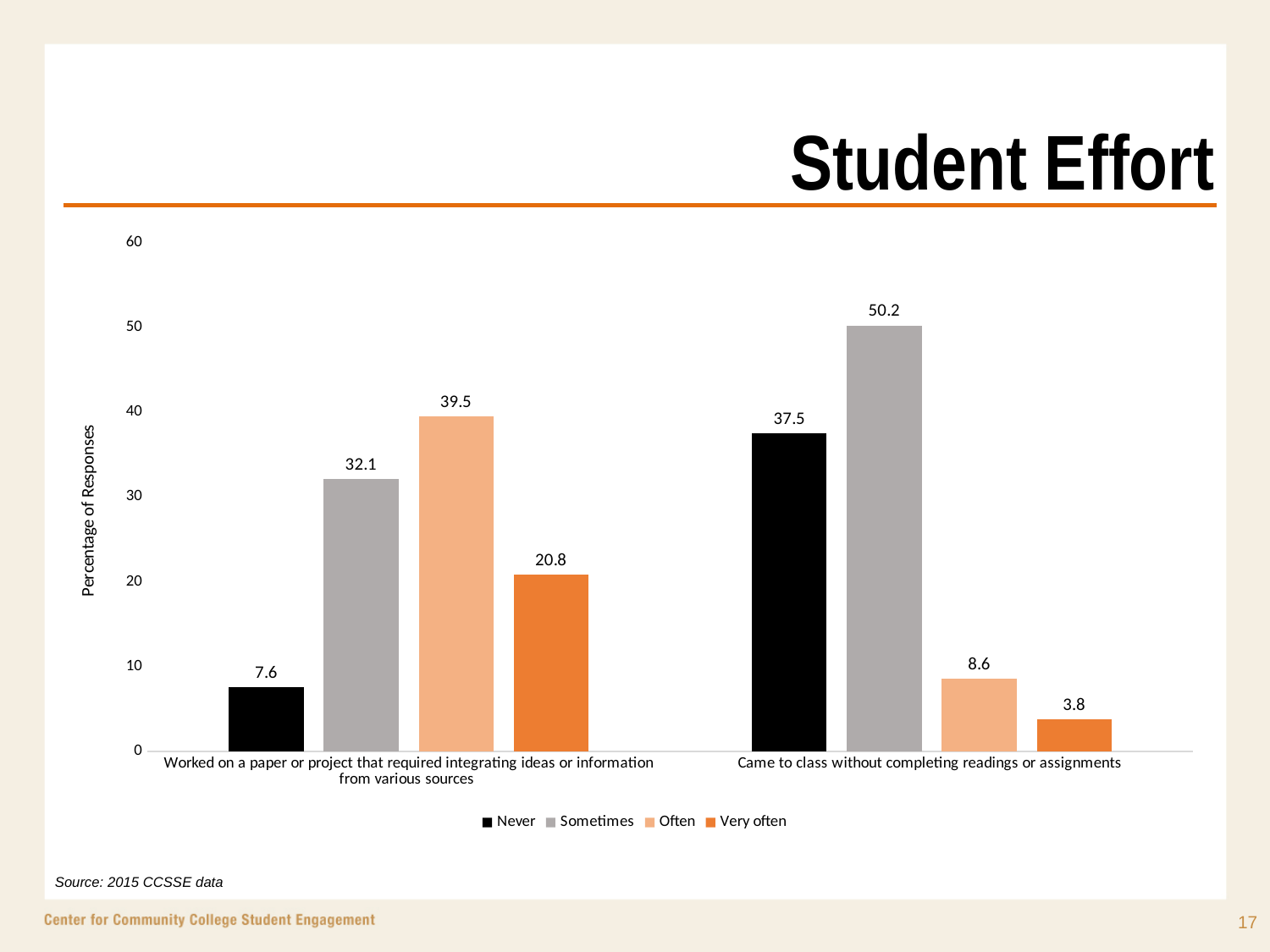
What kind of chart is shown on the slide? Bar chart What is the value for 'Very often' in the 'Came to class without completing readings or assignments' category? 3.8 What is the difference between the 'Sometimes' and 'Never' values for 'Came to class without completing readings or assignments'? 12.7 What is the label of the y axis? Percentage of Responses How many categories are shown on the x axis? 2 How many series does the legend list? 4 Which response option has the lowest value for 'Worked on a paper or project that required integrating ideas or information from various sources'? Never What percentage of responses were 'Often' for 'Worked on a paper or project that required integrating ideas or information from various sources'? 39.5 Which response option has the highest value for 'Came to class without completing readings or assignments'? Sometimes Which is larger: the 'Sometimes' value for 'Worked on a paper or project...' or the 'Sometimes' value for 'Came to class without completing readings or assignments'? Came to class without completing readings or assignments What is the difference between the 'Often' and 'Very often' values for 'Worked on a paper or project that required integrating ideas or information from various sources'? 18.7 What percentage of responses were 'Never' for 'Came to class without completing readings or assignments'? 37.5